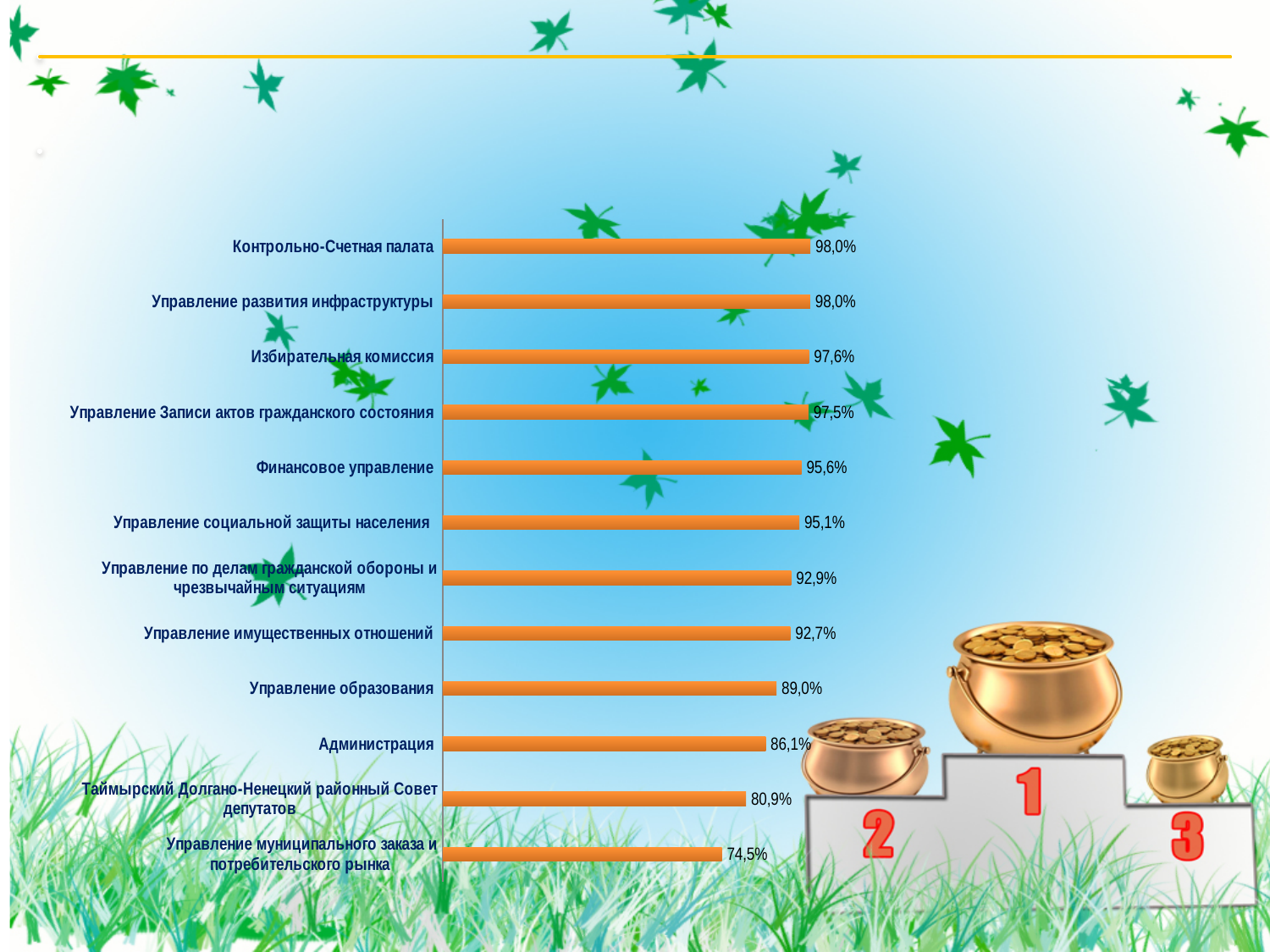
What is the value for Администрация? 86,1% What is the difference between the values for Управление образования and Администрация? 2,9% Which category has the lowest value? Управление муниципального заказа и потребительского рынка What is the value for Финансовое управление? 95,6% What is the difference between the values for Контрольно-Счетная палата and Управление муниципального заказа и потребительского рынка? 23,5% What is the value for Избирательная комиссия? 97,6% How many categories are shown in the chart? 12 Which is larger: the value for Управление социальной защиты населения or the value for Управление имущественных отношений? Управление социальной защиты населения Do the values rise or fall going from the top category to the bottom category? Fall What colour are the bars in the chart? Orange What kind of chart is shown on the slide? Bar chart What is the value for Управление образования? 89,0%